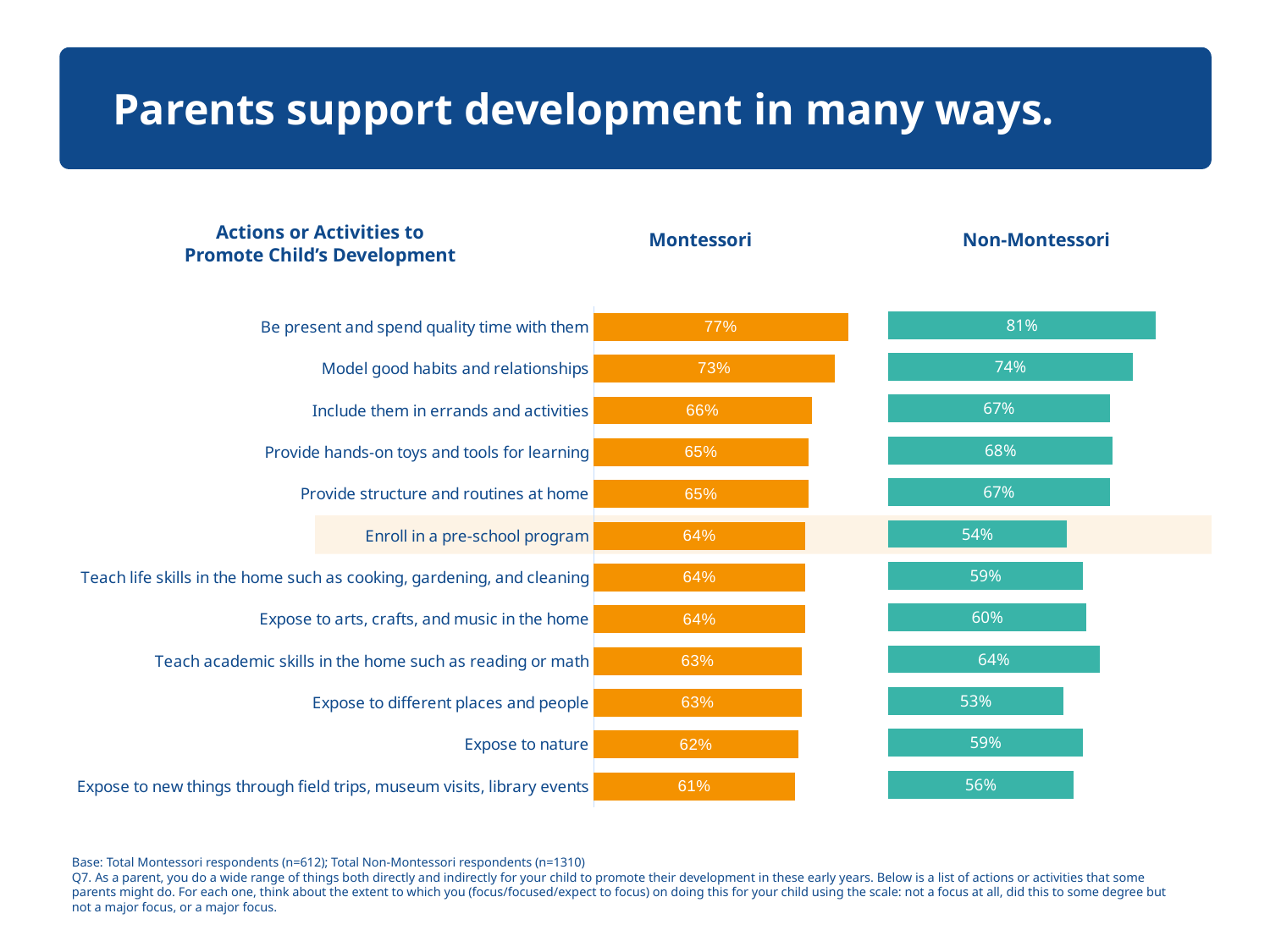
In the Non-Montessori chart, what is the value for "Provide hands-on toys and tools for learning"? 68% In the Non-Montessori chart, which activity has the lowest value? Expose to different places and people What is the title of the slide? Parents support development in many ways. In the Montessori chart, which activity has the highest value? Be present and spend quality time with them How many activities are listed in the Montessori chart? 12 What is the difference between the Non-Montessori and Montessori values for "Expose to different places and people"? 10% In the Montessori chart, what is the value for "Enroll in a pre-school program"? 64% In the Non-Montessori chart, what is the value for "Enroll in a pre-school program"? 54% For "Teach life skills in the home such as cooking, gardening, and cleaning", which is larger: the Montessori value or the Non-Montessori value? Montessori What type of chart is used to show the Non-Montessori values? Bar chart In the Montessori chart, which activity has the lowest value? Expose to new things through field trips, museum visits, library events For "Be present and spend quality time with them", which is larger: the Montessori value or the Non-Montessori value? Non-Montessori